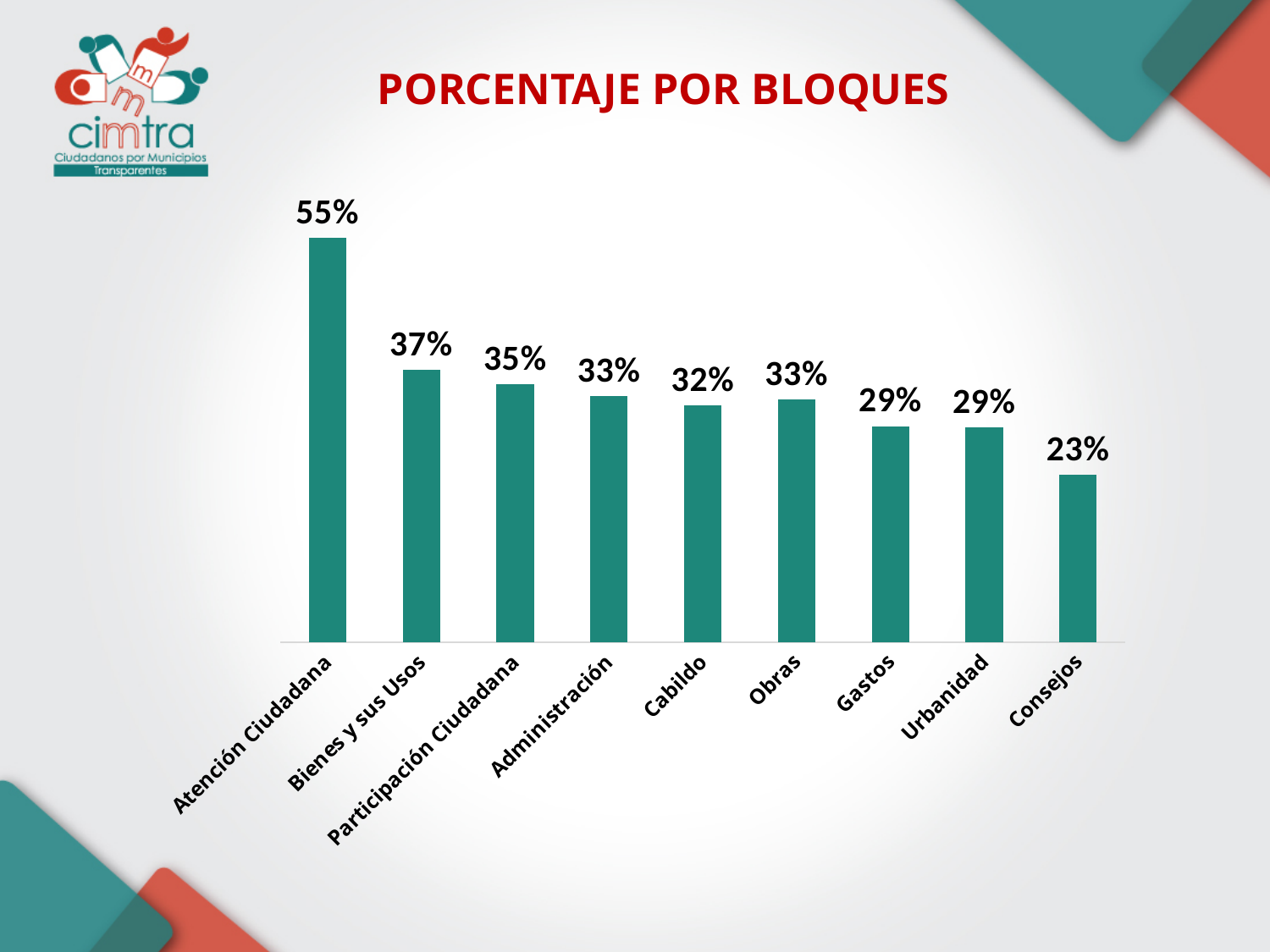
Which category has the lowest value? Consejos What is the title of the chart? PORCENTAJE POR BLOQUES What is the difference between the values for Bienes y sus Usos and Participación Ciudadana? 2% What is the value for Cabildo? 32% Which category has the highest value? Atención Ciudadana What is the value for Consejos? 23% What is the value for Atención Ciudadana? 55% Which is larger, the value for Administración or the value for Gastos? Administración What kind of chart is shown on the slide? Bar chart What is the value for Bienes y sus Usos? 37% What is the difference between the values for Atención Ciudadana and Consejos? 32% How many categories are shown in the chart? 9